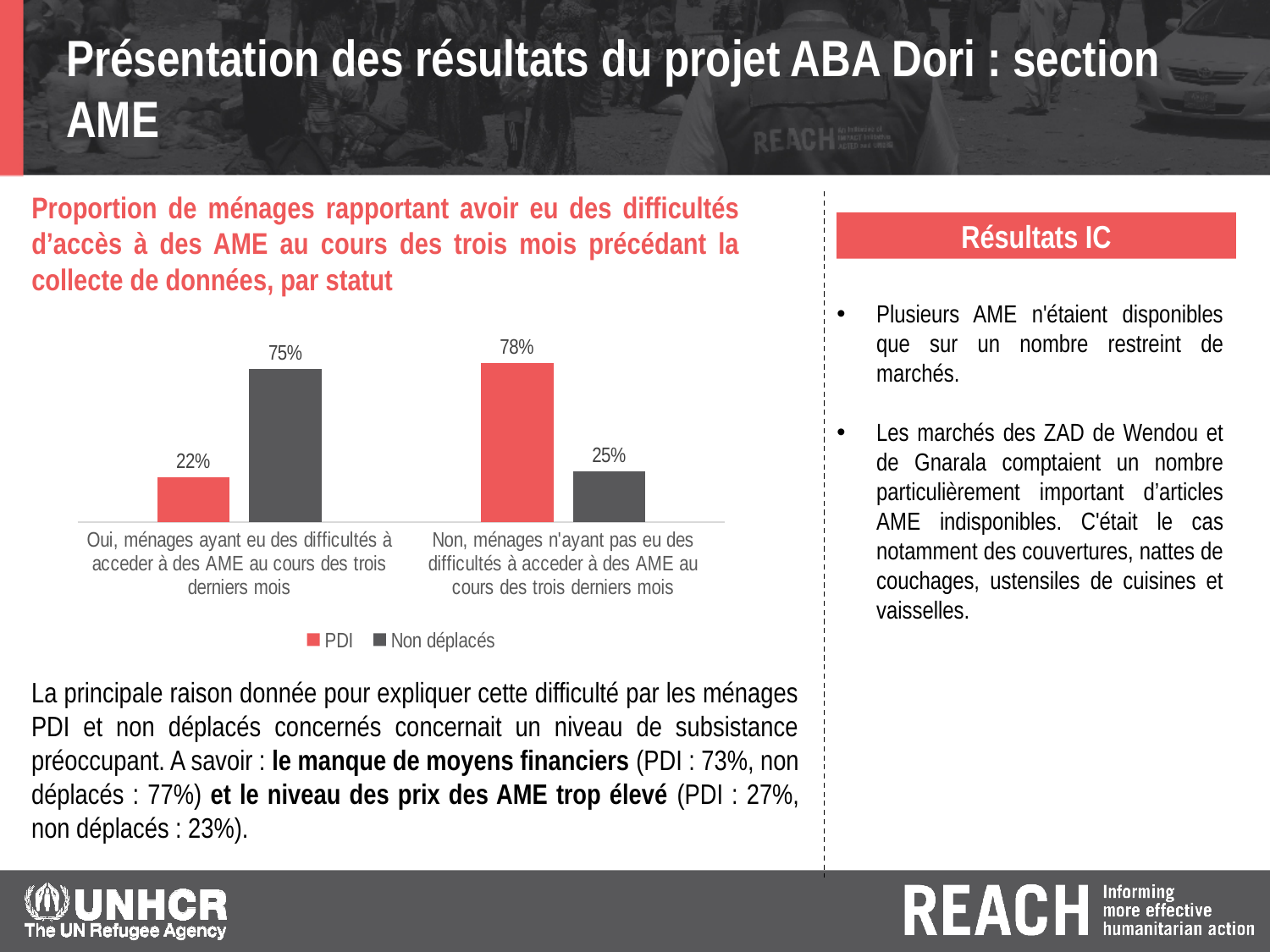
For households that did not have difficulties accessing AME, which group has the larger value, PDI or non-displaced? PDI What percentage of PDI households reported not having had difficulties accessing AME in the last three months? 78% How many series does the legend list? 2 What percentage of non-displaced households reported not having had difficulties accessing AME in the last three months? 25% What percentage of PDI households reported having had difficulties accessing AME in the last three months? 22% How many categories are shown on the x axis of the chart? 2 What is the difference between the PDI and non-displaced values for households that did not have difficulties accessing AME? 53 percentage points What kind of chart is shown on the slide? Bar chart Which series has the highest value in the chart? PDI What is the difference between the non-displaced and PDI values for households that had difficulties accessing AME? 53 percentage points What colour represents the PDI series in the chart? Red What percentage of non-displaced households reported having had difficulties accessing AME in the last three months? 75%